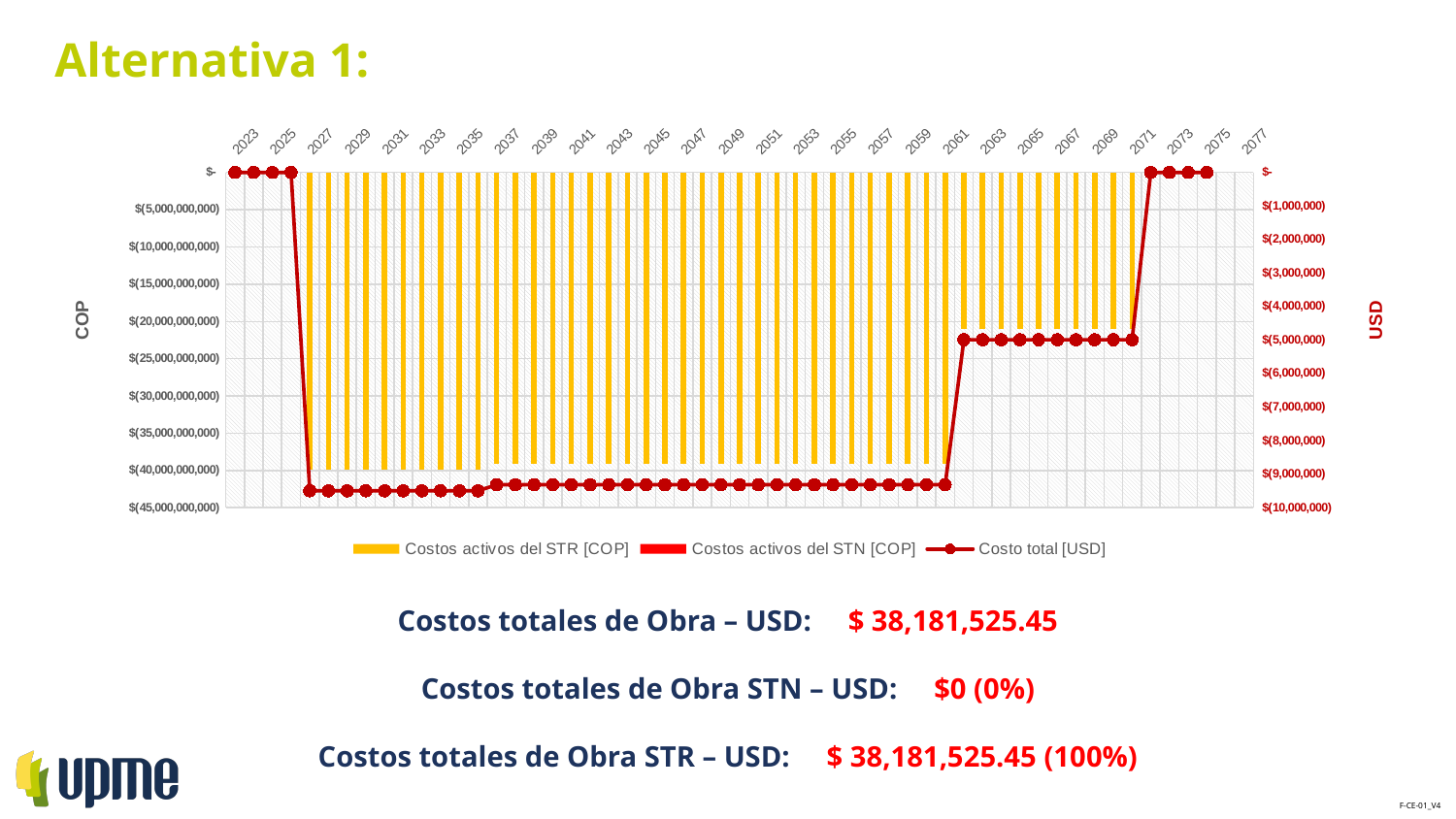
What is the last year shown on the x axis of the chart? 2077 What kind of chart is shown on the slide? A combined bar and line chart Does the Costo total [USD] line rise or fall between 2071 and 2073? Rise Does the Costo total [USD] line rise or fall between 2025 and 2027? Fall What are the three series listed in the chart legend? Costos activos del STR [COP], Costos activos del STN [COP], Costo total [USD] What is the Costo total [USD] value in 2023? $- What is the first year shown on the x axis of the chart? 2023 Which bar series shows no visible bars in the chart? Costos activos del STN [COP] What are the labels of the left and right vertical axes of the chart? COP (left) and USD (right) How many series does the chart legend list? 3 Which is higher (closer to zero), the Costo total [USD] in 2030 or in 2065? 2065 What is the Costo total [USD] value in 2073? $-